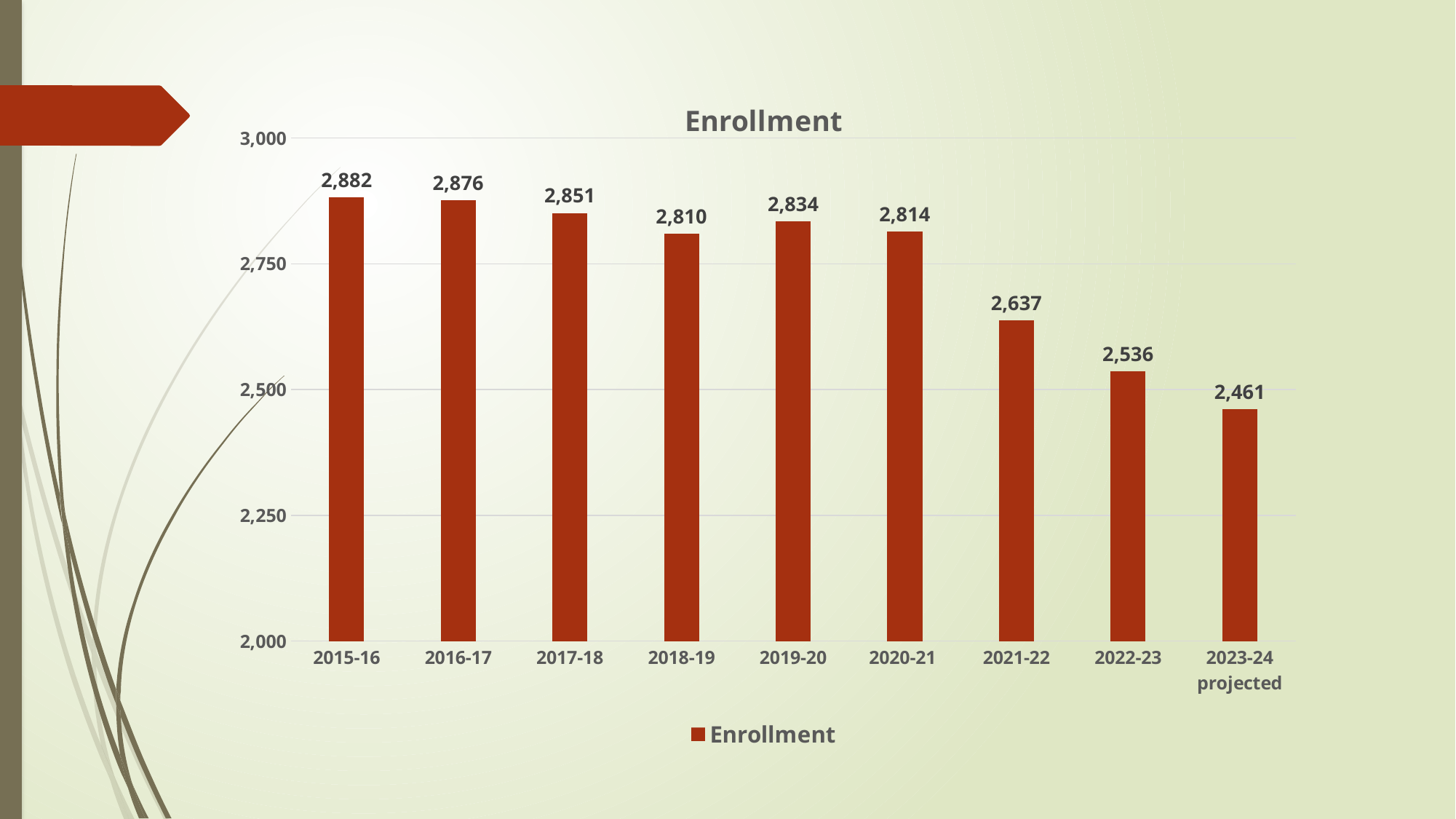
How many school years are shown on the x axis? 9 What is the difference in enrollment between 2015-16 and 2023-24 projected? 421 What is the title of the chart? Enrollment Which year has the lowest enrollment? 2023-24 projected What is the projected enrollment for 2023-24? 2,461 Which year has the highest enrollment? 2015-16 Which is larger, the enrollment for 2019-20 or for 2020-21? 2019-20 Is the enrollment for 2022-23 greater or less than 2,500? greater What is the enrollment value for 2021-22? 2,637 What is the difference in enrollment between 2021-22 and 2022-23? 101 What is the enrollment value for 2015-16? 2,882 What kind of chart is shown on the slide? bar chart